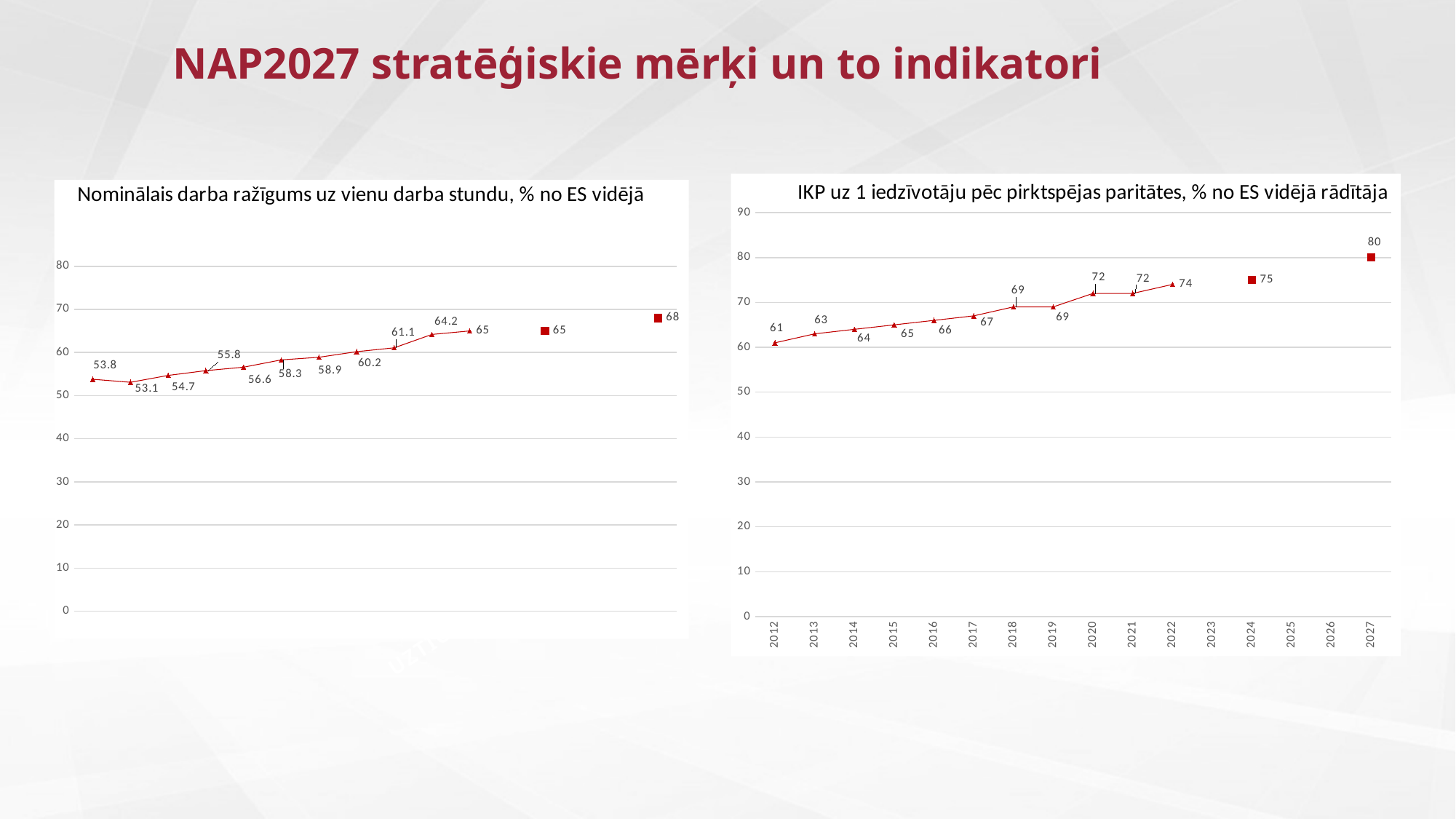
In the chart titled "Nominālais darba ražīgums uz vienu darba stundu, % no ES vidējā", what is the lowest value labelled on the line? 53.1 In the chart titled "IKP uz 1 iedzīvotāju pēc pirktspējas paritātes, % no ES vidējā rādītāja", what is the difference between the 2022 value and the 2012 value? 13 What kind of chart is the chart titled "Nominālais darba ražīgums uz vienu darba stundu, % no ES vidējā"? line chart In the chart titled "IKP uz 1 iedzīvotāju pēc pirktspējas paritātes, % no ES vidējā rādītāja", which year has the lowest value? 2012 In the chart titled "IKP uz 1 iedzīvotāju pēc pirktspējas paritātes, % no ES vidējā rādītāja", do the values generally rise or fall from 2012 to 2022? rise In the chart titled "Nominālais darba ražīgums uz vienu darba stundu, % no ES vidējā", what is the difference between the last line value (65) and the first line value (53.8)? 11.2 In the chart titled "IKP uz 1 iedzīvotāju pēc pirktspējas paritātes, % no ES vidējā rādītāja", what is the value shown for 2024? 75 In the chart titled "IKP uz 1 iedzīvotāju pēc pirktspējas paritātes, % no ES vidējā rādītāja", what is the value for 2022? 74 In the chart titled "IKP uz 1 iedzīvotāju pēc pirktspējas paritātes, % no ES vidējā rādītāja", what is the value for 2012? 61 In the chart titled "Nominālais darba ražīgums uz vienu darba stundu, % no ES vidējā", what is the highest value labelled on the slide? 68 How many charts are shown on the slide? 2 In the chart titled "IKP uz 1 iedzīvotāju pēc pirktspējas paritātes, % no ES vidējā rādītāja", what is the target value shown for 2027? 80